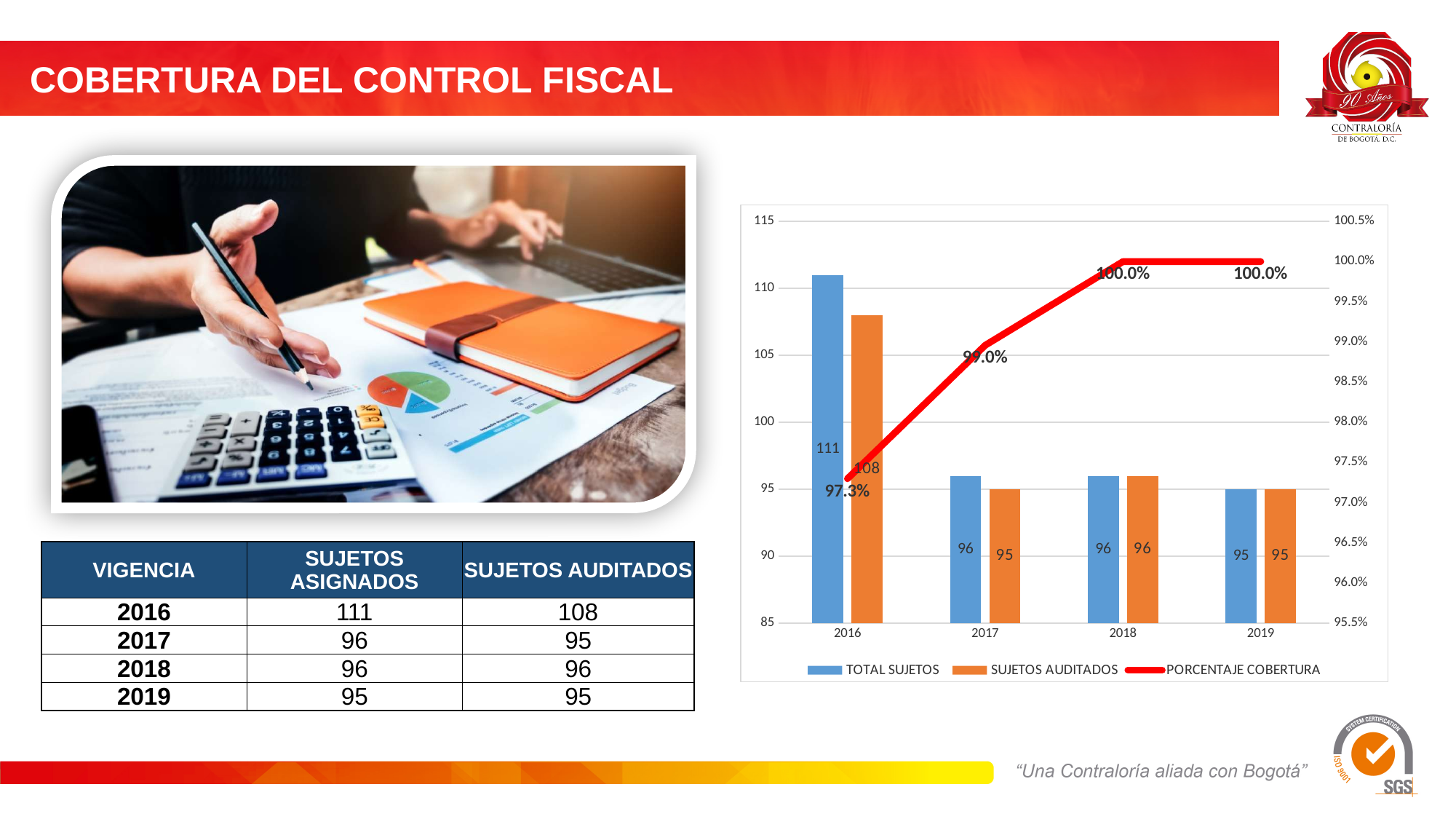
Which is larger in 2017, TOTAL SUJETOS or SUJETOS AUDITADOS? TOTAL SUJETOS How many years are shown on the x axis of the chart? 4 What is the difference between TOTAL SUJETOS and SUJETOS AUDITADOS in 2016? 3 How many series does the chart legend list? 3 What is the PORCENTAJE COBERTURA for 2016? 97.3% Which year has the highest value for TOTAL SUJETOS? 2016 What is the value of SUJETOS AUDITADOS for 2016? 108 Does the PORCENTAJE COBERTURA line rise or fall from 2016 to 2018? rise Which year has the lowest PORCENTAJE COBERTURA? 2016 What is the PORCENTAJE COBERTURA for 2017? 99.0% What is the value of TOTAL SUJETOS for 2016? 111 What colour is the PORCENTAJE COBERTURA line in the chart? Red